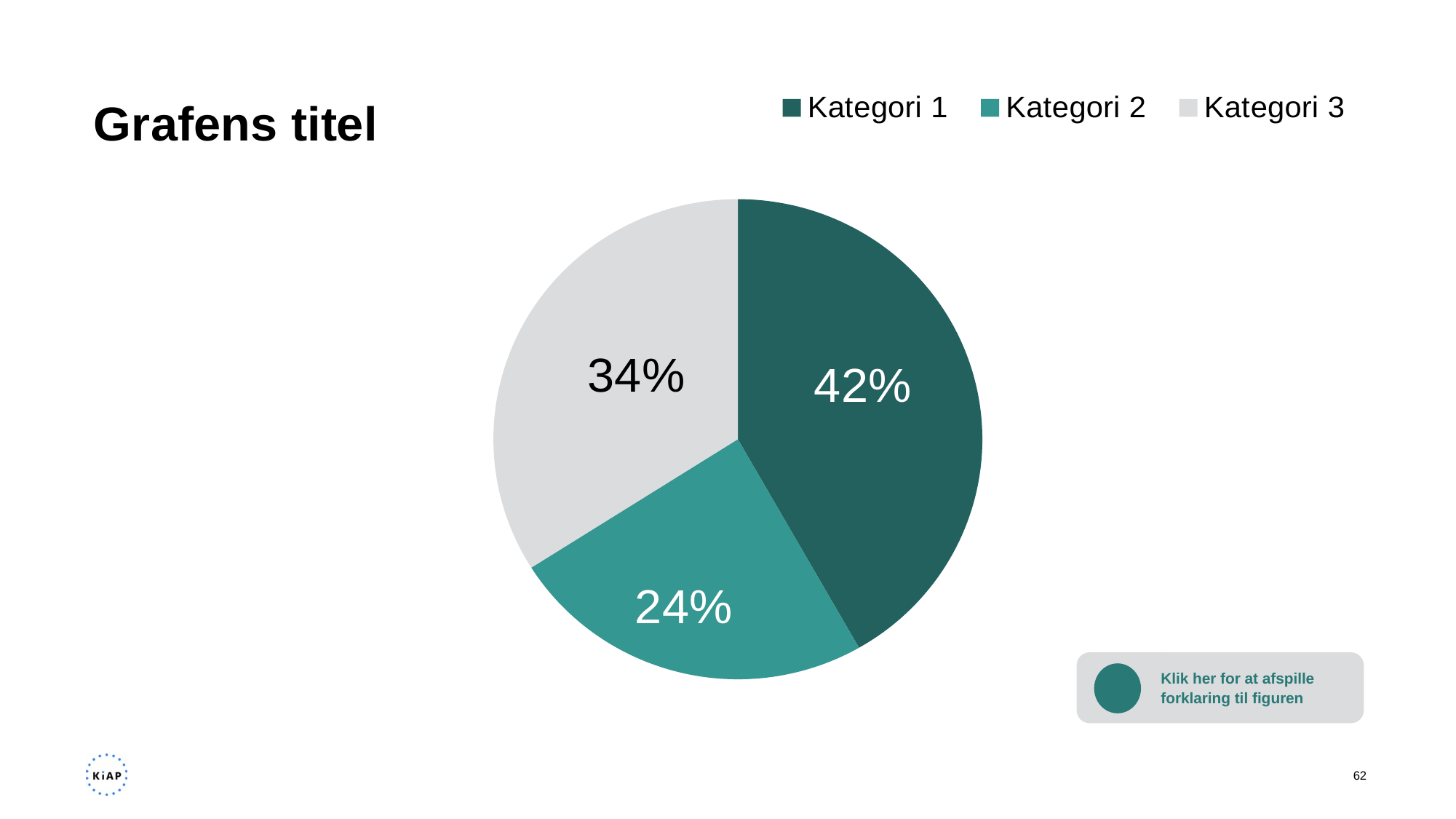
What is the difference between the values for Kategori 3 and Kategori 2? 10% What is the difference between the values for Kategori 1 and Kategori 2? 18% Which category has the largest slice of the pie? Kategori 1 What is the value shown for Kategori 1? 42% What is the value shown for Kategori 3? 34% How many slices does the pie chart have? 3 What is the title of the chart? Grafens titel Which category has the smallest slice of the pie? Kategori 2 How many entries does the legend list? 3 What kind of chart is shown on the slide? pie chart What is the value shown for Kategori 2? 24% Which is larger, the slice for Kategori 3 or the slice for Kategori 2? Kategori 3